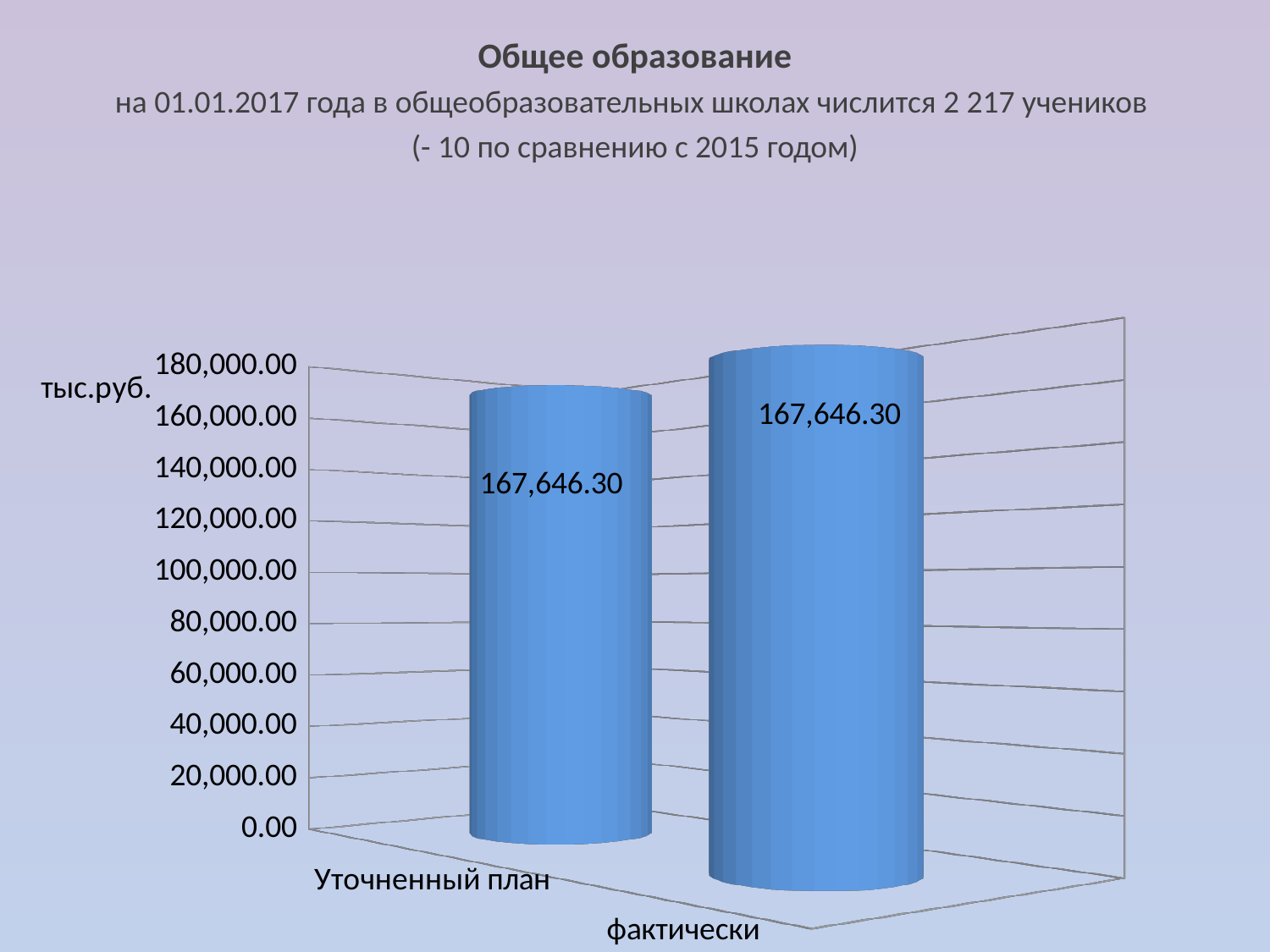
What unit is shown next to the vertical axis of the chart? тыс.руб. What is the value for Уточненный план? 167,646.30 What is the value for фактически? 167,646.30 Is the value for Уточненный план greater or less than 180,000.00? less Is the value for фактически greater or less than 160,000.00? greater What is the difference between the values for Уточненный план and фактически? 0.00 What is the highest tick value shown on the vertical axis? 180,000.00 How many categories are shown on the x axis of the chart? 2 What kind of chart is shown on the slide? bar chart